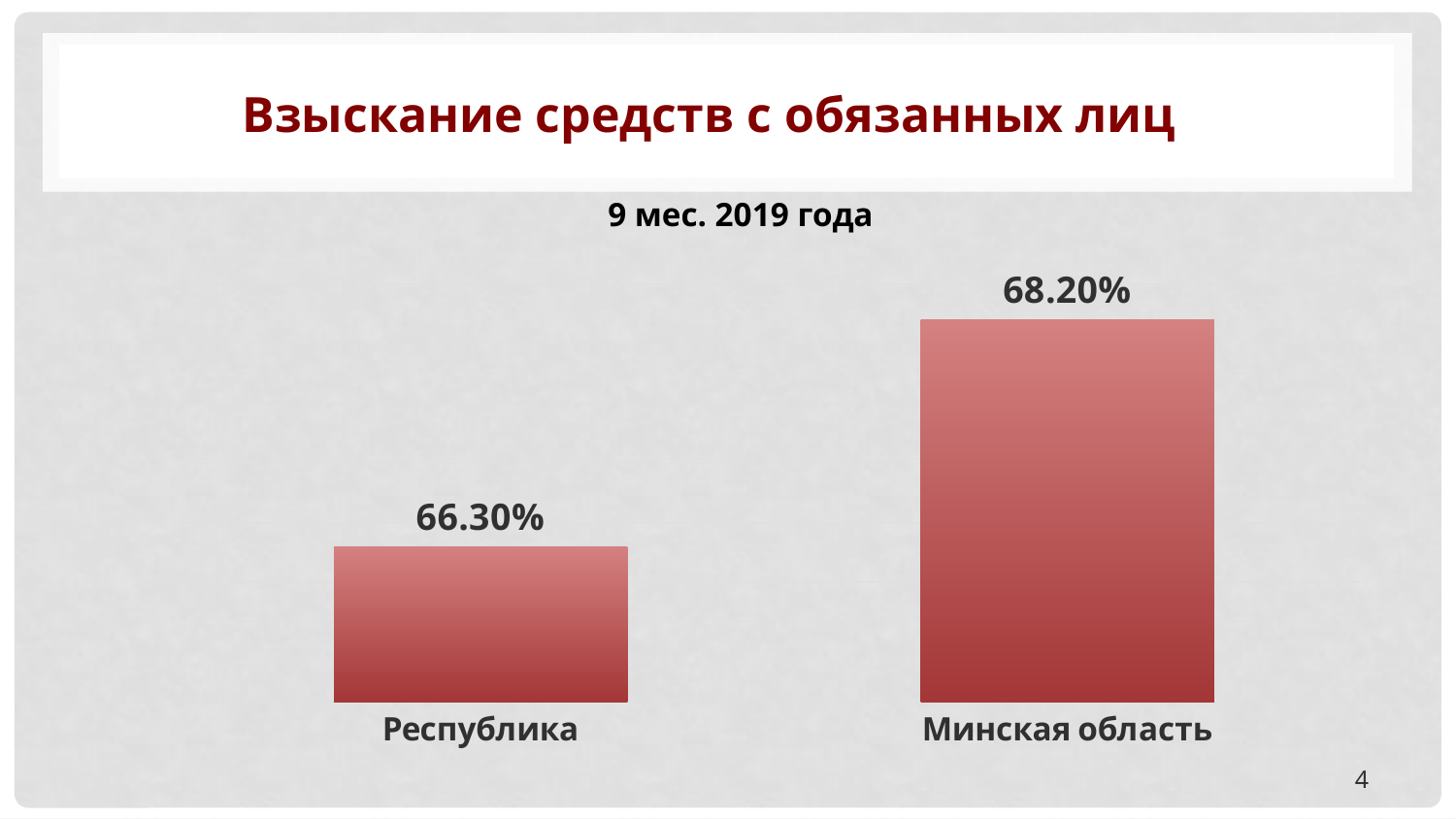
Which category has the lowest value? Республика Which category has the highest value? Минская область How many categories are shown in the chart? 2 What is the value for Минская область? 68.20% What is the title of the slide? Взыскание средств с обязанных лиц Which is larger, the value for Республика or the value for Минская область? Минская область What is the title of the chart? 9 мес. 2019 года What is the value for Республика? 66.30% What is the difference between the values for Минская область and Республика? 1.90% What kind of chart is shown on the slide? Bar chart